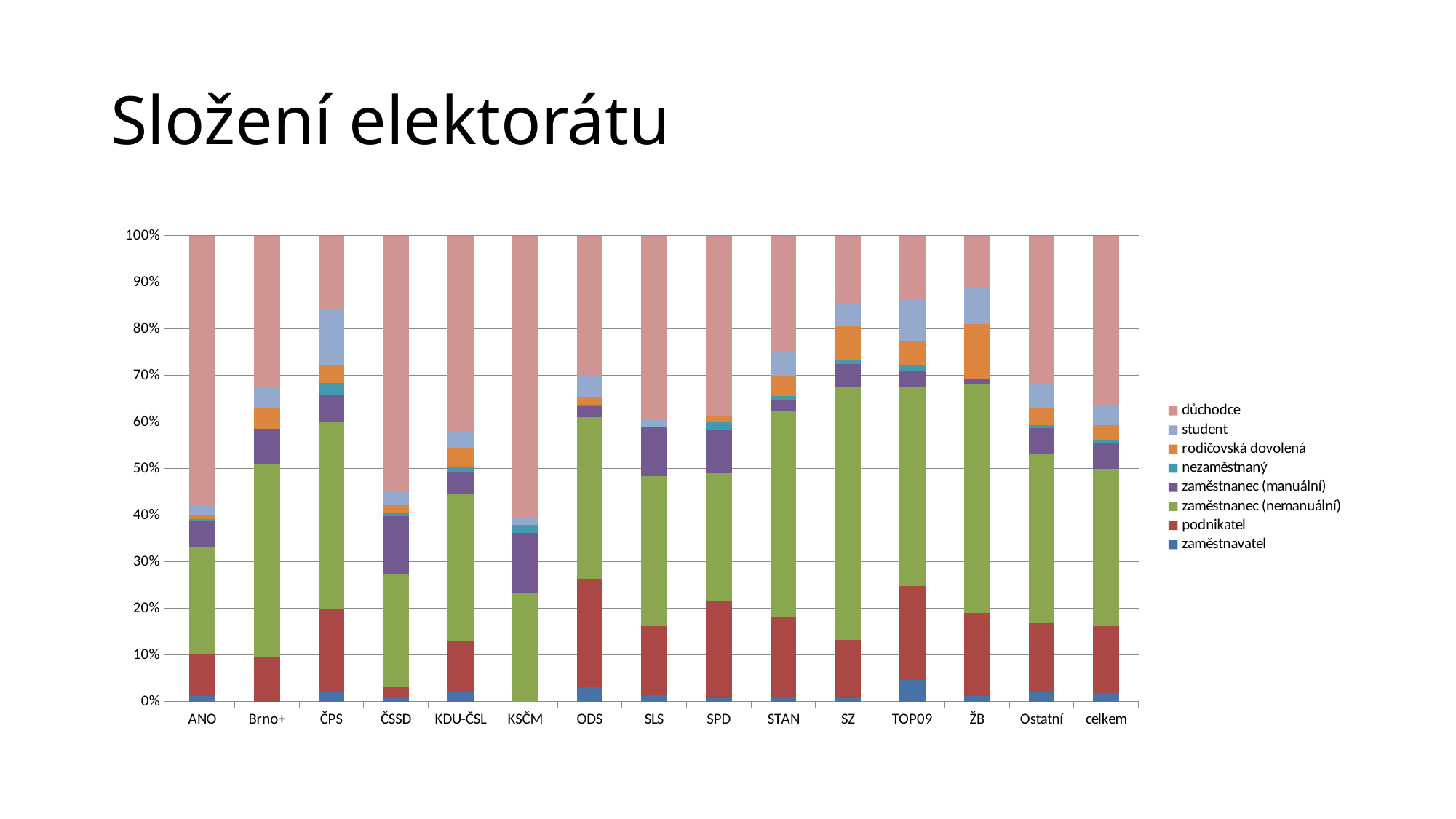
Which category has the largest student segment in the chart? ČPS How many series does the chart's legend list? 8 Which category has the largest zaměstnanec (nemanuální) segment in the chart? SZ Which legend entry is listed first (at the top) in the chart's legend? důchodce Which category has the largest důchodce share in the chart? KSČM What kind of chart is shown on the slide? Stacked bar chart How many categories are shown along the x axis of the chart? 15 Is the důchodce share for KSČM larger or smaller than the důchodce share for ODS? larger What is the title of the slide containing the chart? Složení elektorátu Is the důchodce share for KSČM greater or less than 50%? greater